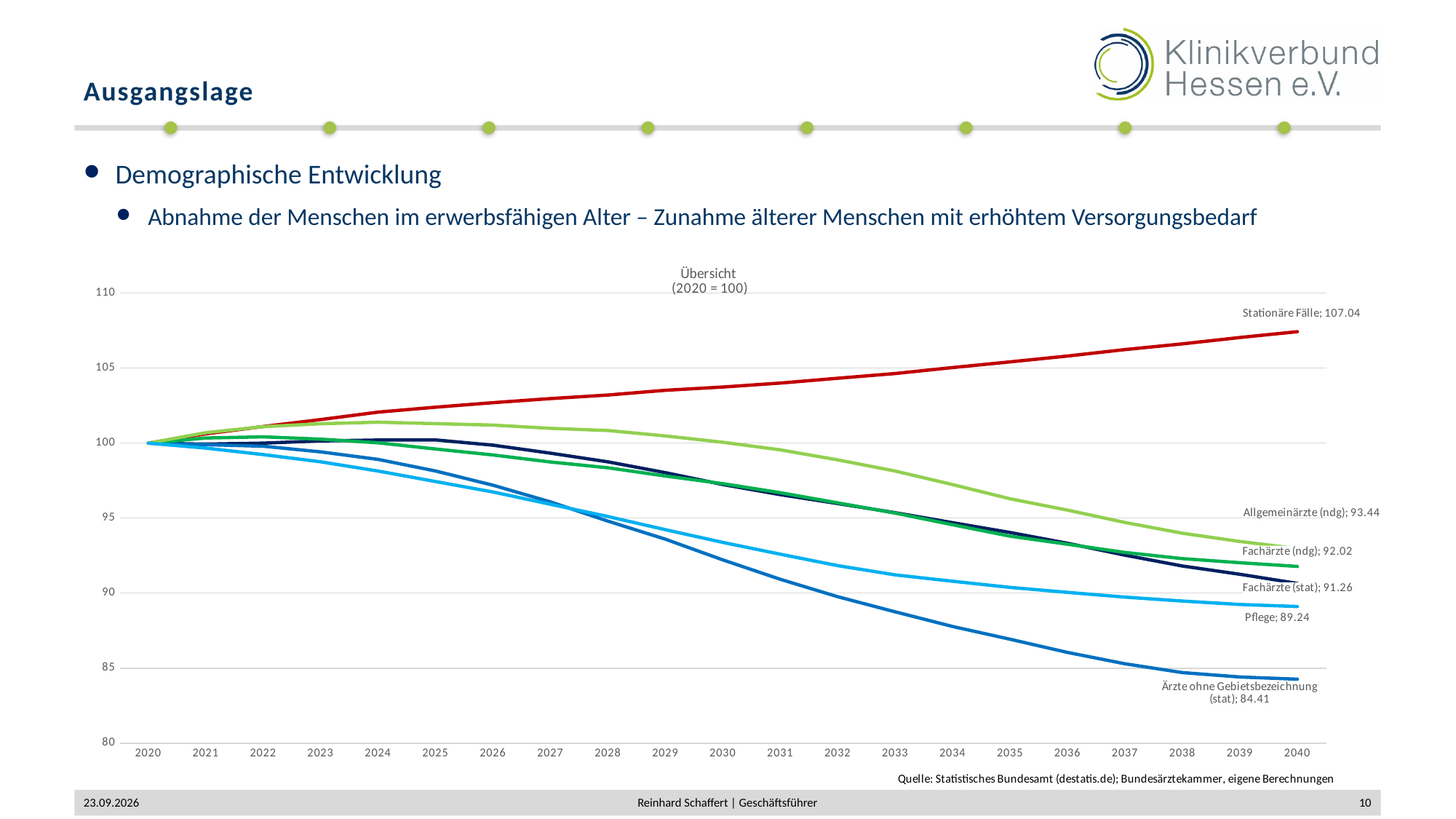
Which series has the lowest value in 2040? Ärzte ohne Gebietsbezeichnung (stat) How many years are shown on the x axis? 21 Does the Stationäre Fälle line rise or fall from 2020 to 2040? rise Which series has the highest value in 2040? Stationäre Fälle What is the value for Stationäre Fälle in 2040? 107.04 Is the value for Ärzte ohne Gebietsbezeichnung (stat) in 2032 greater or less than 95? less In 2040, which is larger: Allgemeinärzte (ndg) or Fachärzte (stat)? Allgemeinärzte (ndg) What is the value for Fachärzte (ndg) in 2040? 92.02 What is the value for Ärzte ohne Gebietsbezeichnung (stat) in 2040? 84.41 What is the value for Pflege in 2040? 89.24 What is the difference between the 2040 values of Stationäre Fälle and Pflege? 17.80 What type of chart is shown on the slide? line chart